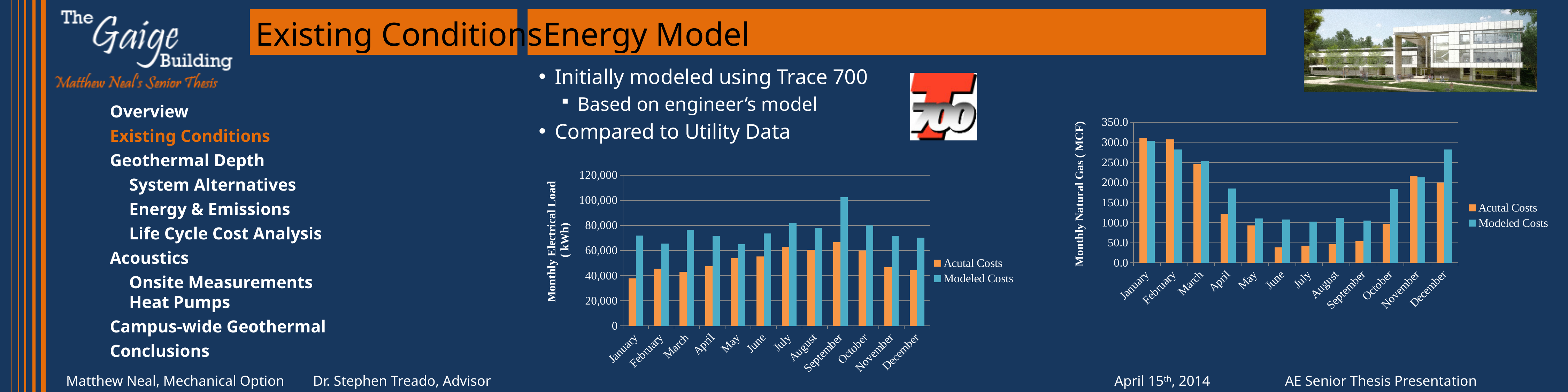
In the Monthly Electrical Load chart, is the Acutal Costs value for January greater or less than 40,000? less In the Monthly Electrical Load chart, which month has the highest Modeled Costs value? September In the Monthly Natural Gas chart, is the Acutal Costs value for April greater or less than 150.0? less In the Monthly Electrical Load chart, which is larger in September, Acutal Costs or Modeled Costs? Modeled Costs What is the y-axis title of the chart on the right of the slide? Monthly Natural Gas ( MCF) How many months are shown on the x axis of the Monthly Natural Gas chart? 12 How many series does the legend of the Monthly Electrical Load chart list? 2 In the Monthly Electrical Load chart, which month has the lowest Acutal Costs value? January What kind of chart is the Monthly Electrical Load chart? bar chart In the Monthly Natural Gas chart, which month has the highest Modeled Costs value? January In the Monthly Natural Gas chart, do the Acutal Costs values rise or fall from January to June? fall In the Monthly Electrical Load chart, is the Modeled Costs value for September greater or less than 100,000? greater